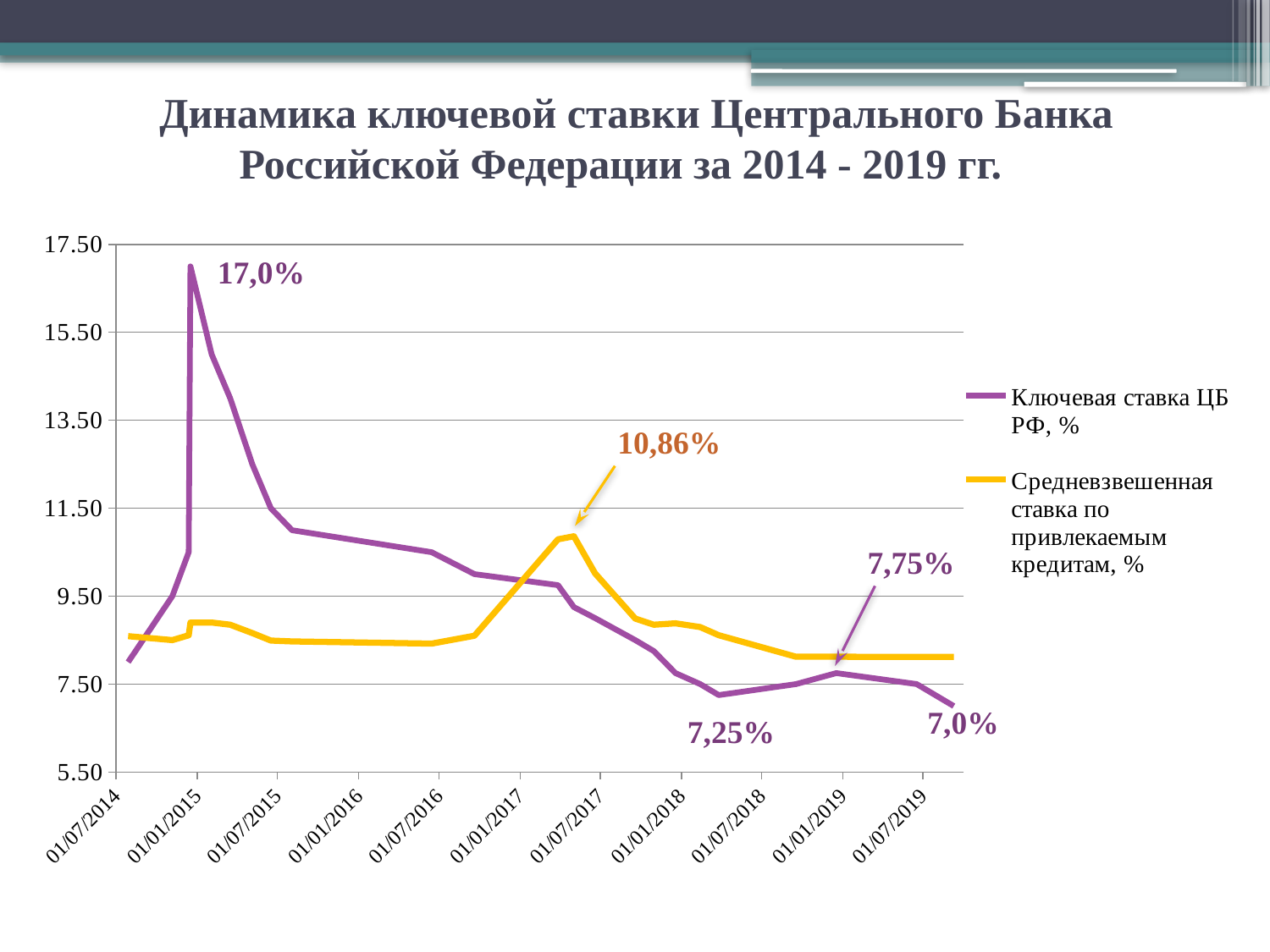
What is the peak labelled value of the weighted average rate on attracted loans (Средневзвешенная ставка по привлекаемым кредитам)? 10,86% What colour is the line for the key rate of the Central Bank of the Russian Federation? Purple Is the key rate at 01/07/2014 greater or less than 9.50? less What is the lowest labelled value of the key rate in 2018? 7,25% What is the difference between the labelled peak of the key rate (17,0%) and its final labelled value (7,0%)? 10,0 percentage points What is the labelled value of the key rate at the end of the series in 2019? 7,0% Does the key rate rise or fall between 01/07/2015 and 01/07/2018? Fall What labelled value does the key rate have around 01/01/2019? 7,75% At 01/01/2016, which series is higher: the key rate or the weighted average rate on attracted loans? Key rate (Ключевая ставка ЦБ РФ) What kind of chart is shown on the slide? Line chart What is the highest labelled value of the key rate of the Central Bank of the Russian Federation (Ключевая ставка ЦБ РФ)? 17,0% How many series does the legend list? 2